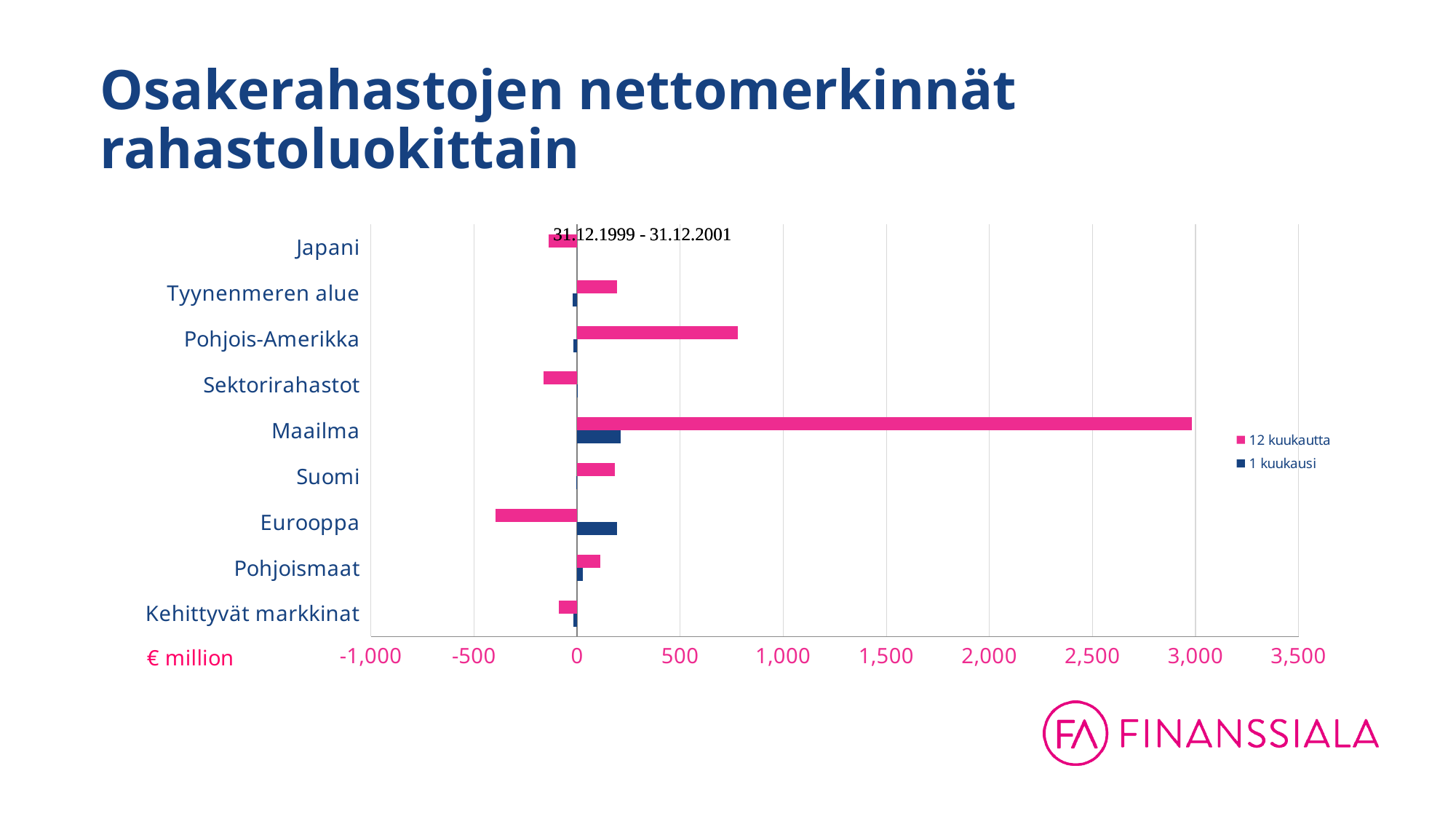
Which has the larger 12 kuukautta value, Pohjois-Amerikka or Suomi? Pohjois-Amerikka Is the 12 kuukautta value for Eurooppa greater or less than 0? less What kind of chart is shown on the slide? bar chart How many series does the chart legend list? 2 Which category has the lowest (most negative) value for the 12 kuukautta series? Eurooppa What unit is shown for the x axis of the chart? € million Is the 12 kuukautta value for Pohjois-Amerikka greater or less than 500? greater How many fund categories are shown on the chart? 9 Which category has the highest value for the 12 kuukautta series? Maailma Which has the larger 1 kuukausi value, Eurooppa or Pohjoismaat? Eurooppa Is the 12 kuukautta value for Maailma greater or less than 2,500? greater